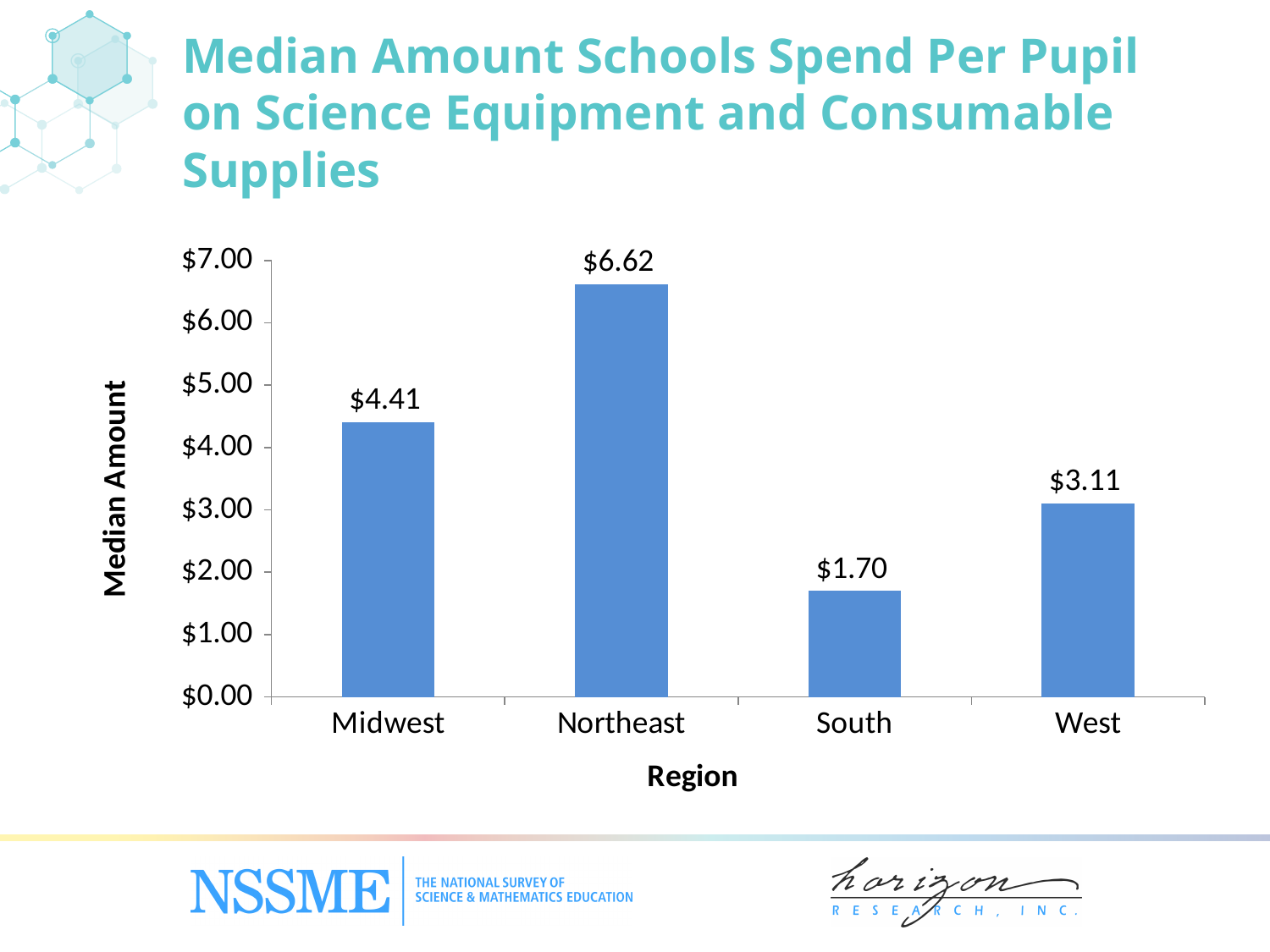
What is the median amount spent per pupil in the West? $3.11 What is the difference between the median amounts for the Midwest and the West? $1.30 What is the median amount spent per pupil in the Midwest? $4.41 What is the median amount spent per pupil in the South? $1.70 Which region has a larger median amount, Midwest or West? Midwest What is the difference between the median amounts for the Northeast and the South? $4.92 What is the median amount spent per pupil in the Northeast? $6.62 Which region has the lowest median amount spent per pupil? South What kind of chart is shown on the slide? Bar chart How many regions are shown on the chart? 4 Is the value for the West greater or less than $4.00? less Which region has the highest median amount spent per pupil? Northeast